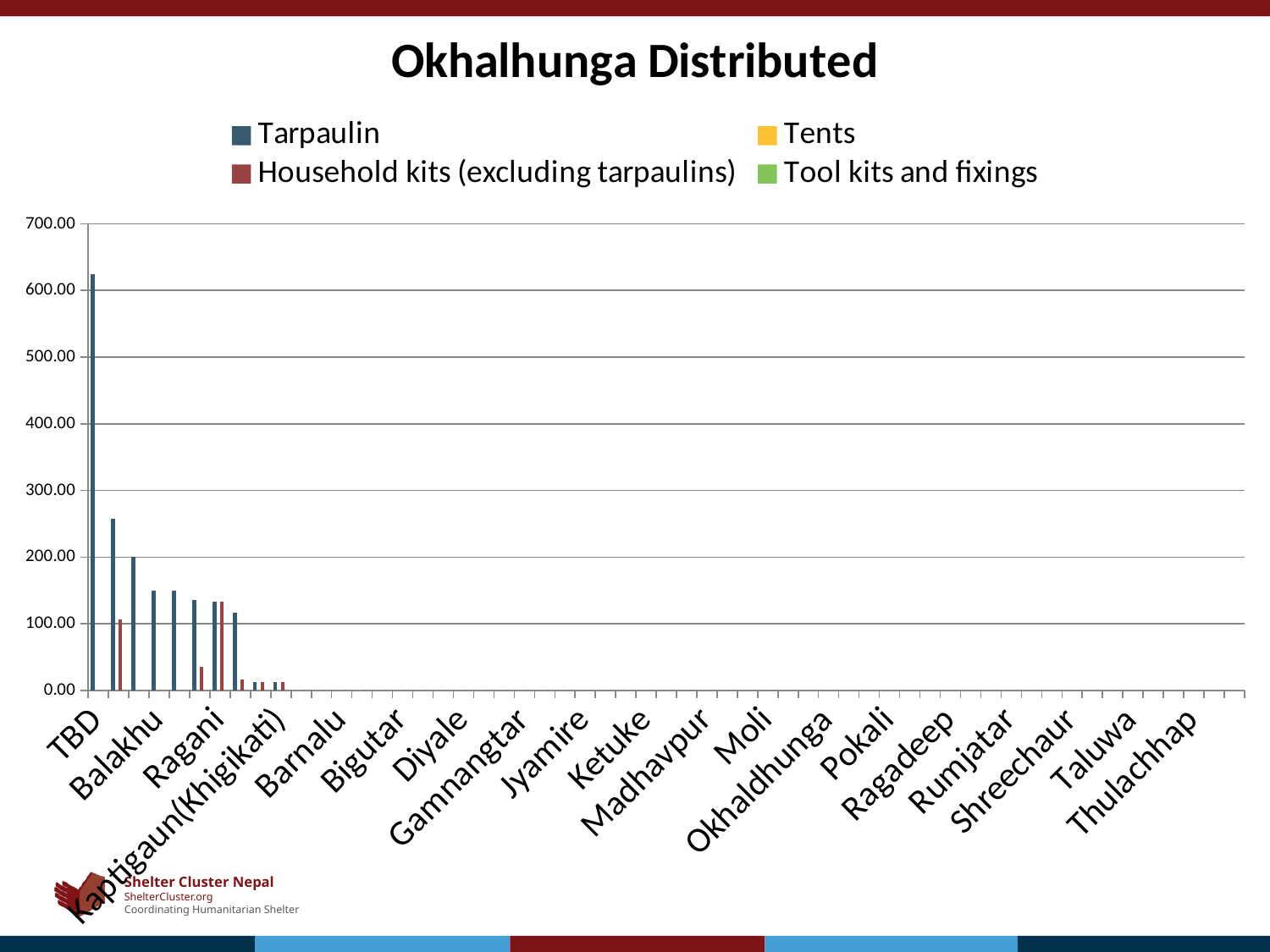
What is the title of the chart? Okhalhunga Distributed How many series does the legend list? 4 What colour represents the Tarpaulin series in the legend? dark blue Which category has the highest Tarpaulin value? TBD What kind of chart is shown on the slide? bar chart Which is larger, the Tarpaulin value for TBD or for Balakhu? TBD Which series has the tallest bar on the chart? Tarpaulin Is the Tarpaulin value for TBD greater or less than 600? greater Is the Tarpaulin value for Barnalu greater or less than 100? less Is the Tarpaulin value for Ragani greater or less than 200? less Do the Tarpaulin values generally rise or fall moving from left to right along the x axis? fall